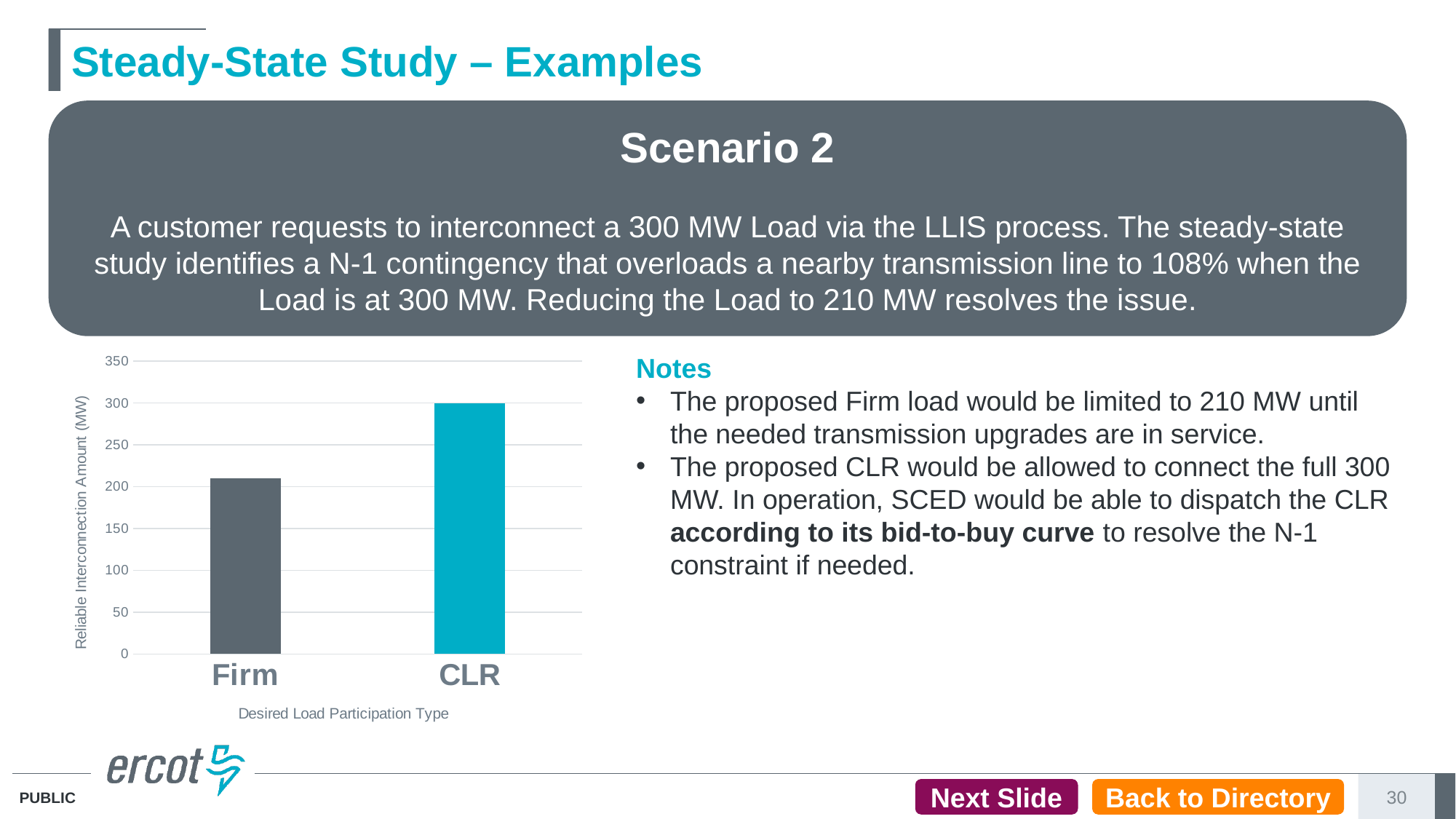
Which category has the lowest Reliable Interconnection Amount in the chart? Firm Is the value for Firm greater or less than 200? greater How many categories are plotted on the x axis of the chart? 2 What kind of chart is shown on the slide? bar chart Which is larger in the chart, the value for Firm or the value for CLR? CLR Which category has the highest Reliable Interconnection Amount in the chart? CLR What is the Reliable Interconnection Amount (MW) for CLR in the chart? 300 Is the value for Firm greater or less than 250? less What is the label of the x axis of the chart? Desired Load Participation Type Is the value for CLR greater or less than 250? greater What is the label of the y axis of the chart? Reliable Interconnection Amount (MW) What is the maximum value shown on the y axis of the chart? 350